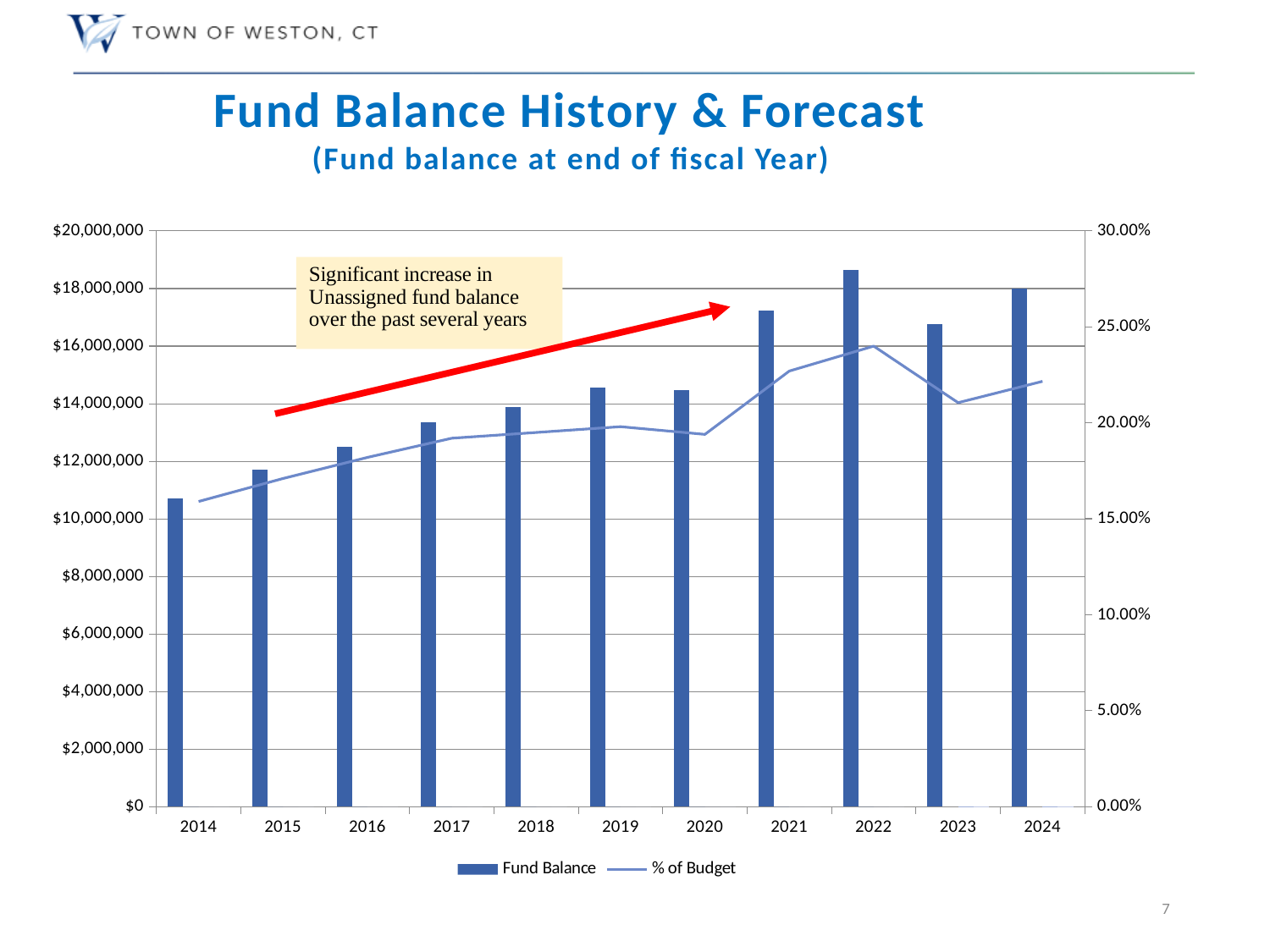
Is the Fund Balance for 2022 greater or less than $18,000,000? greater Which year has the highest Fund Balance bar? 2022 What kind of chart is shown on the slide? A bar chart with a line series Does the Fund Balance rise or fall from 2014 to 2019? rise How many years are shown on the x axis? 11 Is the Fund Balance for 2017 greater or less than $14,000,000? less Is the % of Budget value for 2022 greater or less than 25.00%? less What are the two entries in the chart legend? Fund Balance and % of Budget Which year has the larger Fund Balance, 2021 or 2023? 2021 Which year has the lowest Fund Balance bar? 2014 How many series does the legend list? 2